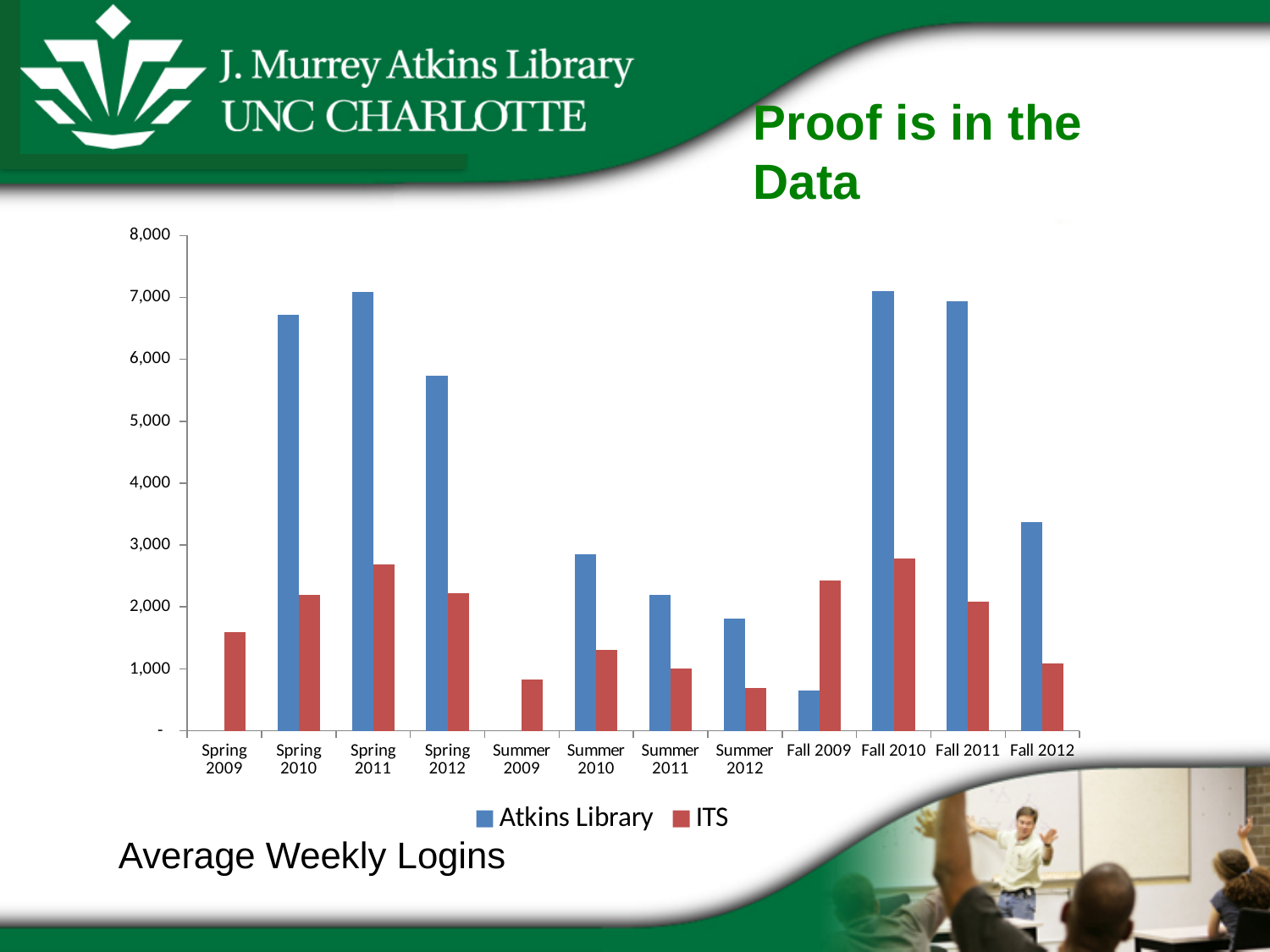
In Spring 2011, which series has the larger value, Atkins Library or ITS? Atkins Library Is the Atkins Library value for Fall 2012 greater or less than 3,000? greater What colour represents the ITS series in the legend? red How many series does the legend list? 2 How many categories are shown on the x axis? 12 Is the ITS value for Summer 2009 greater or less than 1,000? less Do the Atkins Library values rise or fall from Summer 2010 through Summer 2012? fall In Fall 2009, which series has the larger value, Atkins Library or ITS? ITS Is the Atkins Library value for Spring 2010 greater or less than 6,000? greater What kind of chart is shown on the slide? bar chart Which is larger for Atkins Library: Summer 2010 or Summer 2012? Summer 2010